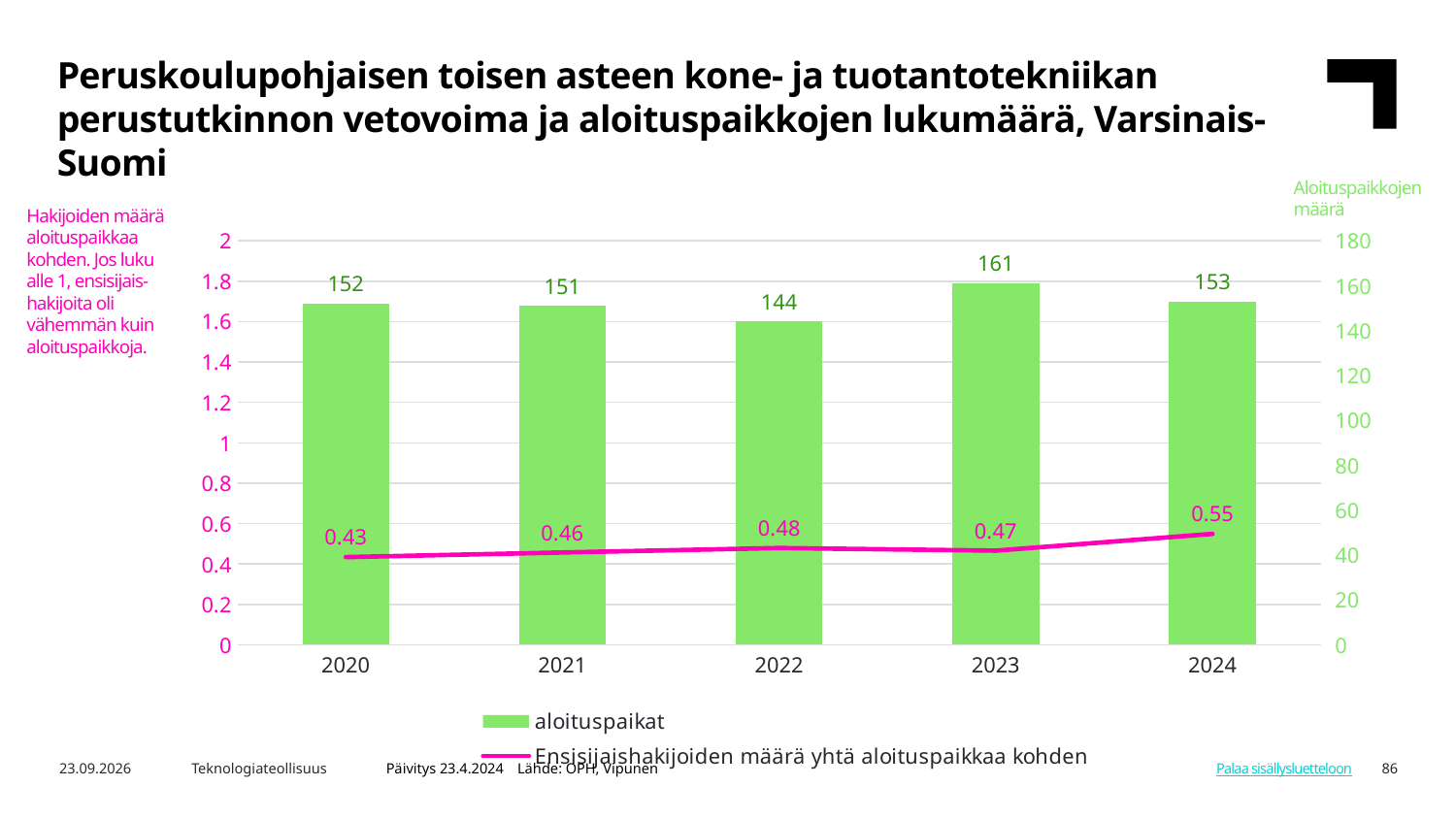
How many series does the legend list? 2 Which is larger, the aloituspaikat value for 2020 or for 2024? 2024 Is the aloituspaikat value for 2021 greater or less than 140? greater Which year has the highest value for aloituspaikat? 2023 What is the difference between the aloituspaikat values for 2023 and 2022? 17 What is the value of aloituspaikat for 2022? 144 What kind of chart is used for the aloituspaikat series? bar chart What is the value of aloituspaikat for 2023? 161 Which year has the lowest value for Ensisijaishakijoiden määrä yhtä aloituspaikkaa kohden? 2020 What colour is the line for Ensisijaishakijoiden määrä yhtä aloituspaikkaa kohden? pink How many years are shown on the x axis? 5 What is the value of Ensisijaishakijoiden määrä yhtä aloituspaikkaa kohden for 2024? 0.55